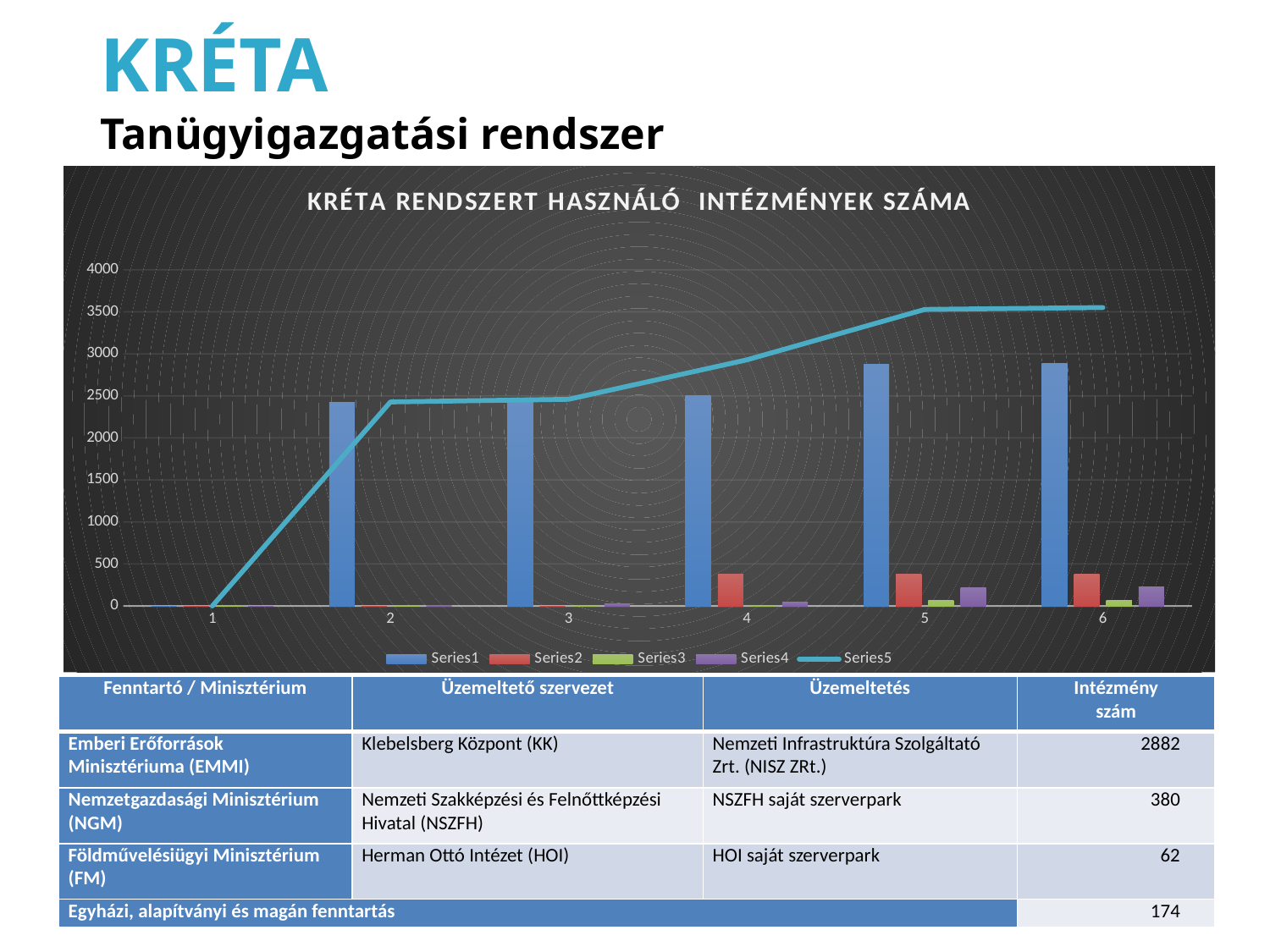
Does the Series5 line rise or fall from category 1 to category 6? rise How many series does the chart legend list? 5 Is the Series5 value for category 5 greater or less than 3000? greater Which is larger, the Series5 value for category 4 or for category 5? category 5 Which category has the lowest Series1 value? 1 Is the Series1 value for category 5 greater or less than 2500? greater Is the Series1 value for category 2 greater or less than 2000? greater What is the title of the chart? KRÉTA RENDSZERT HASZNÁLÓ INTÉZMÉNYEK SZÁMA Which is larger, the Series1 value for category 2 or for category 5? category 5 Which series in the chart is drawn as a line rather than bars? Series5 How many categories are shown on the x axis of the chart? 6